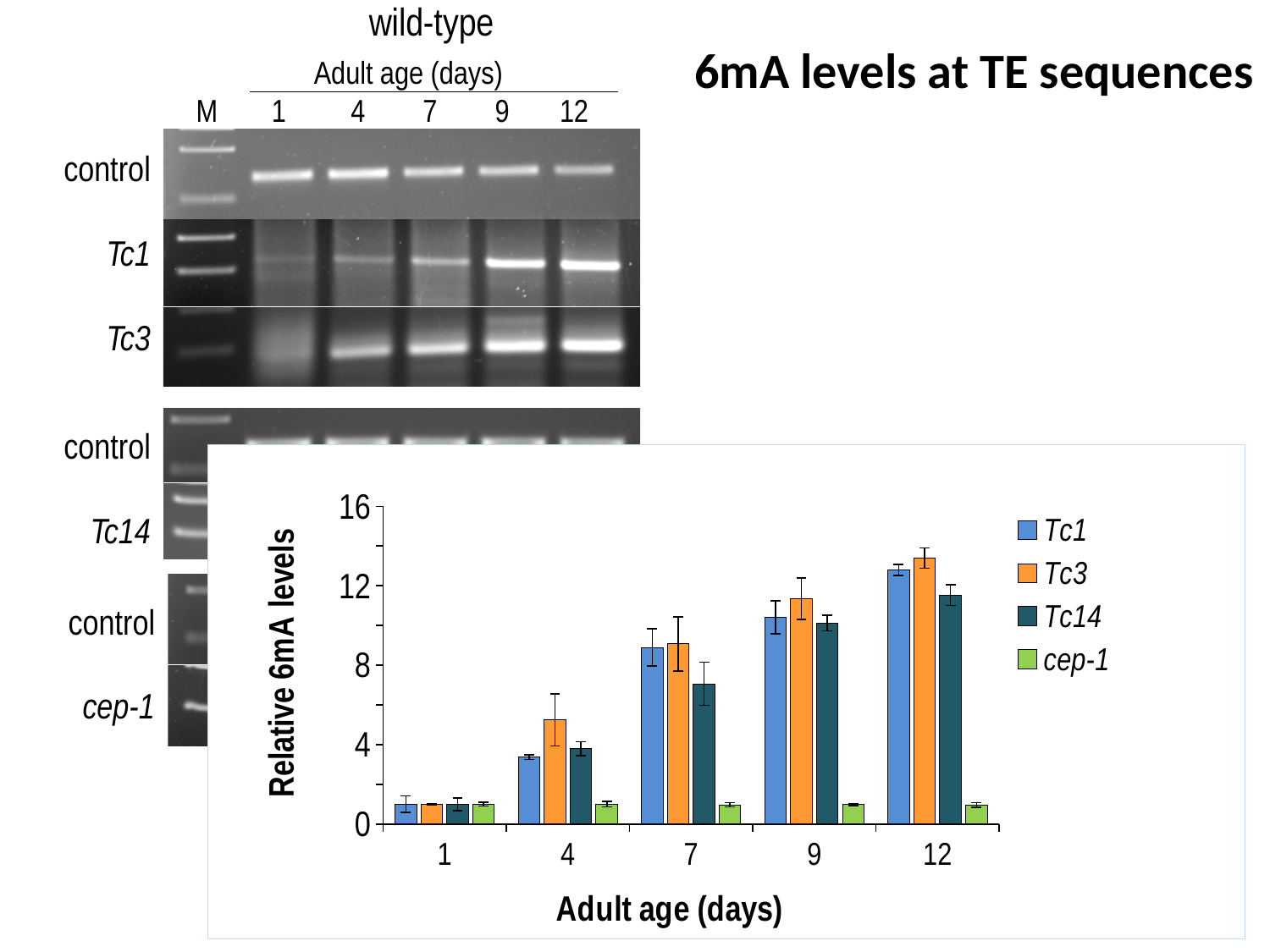
At adult age 12 days, which series has the lowest relative 6mA level? cep-1 How many series does the legend of the chart list? 4 At which adult age is the Tc3 relative 6mA level lowest? 1 How many adult age categories are shown on the x axis of the chart? 5 At adult age 9 days, which is larger, the value for Tc3 or the value for cep-1? Tc3 Is the value for Tc3 at adult age 12 days greater or less than 12? greater Is the value for Tc14 at adult age 7 days greater or less than 8? less Do the Tc1 values rise or fall as adult age increases along the x axis? rise What kind of chart is shown on the slide? bar chart At which adult age is the Tc1 relative 6mA level highest? 12 What is the label of the y axis of the chart? Relative 6mA levels Which series is shown in green in the chart? cep-1